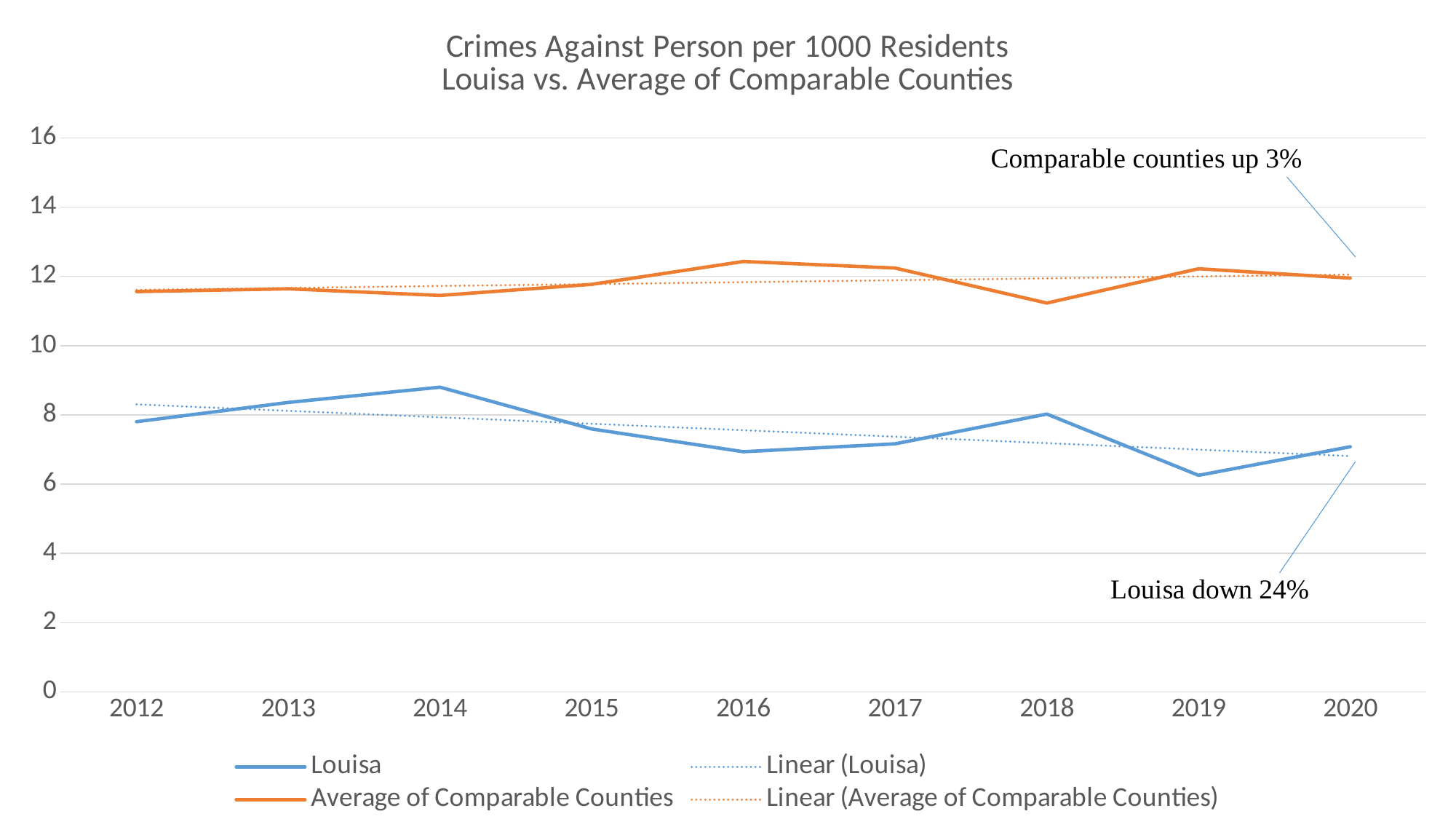
In which year is the Average of Comparable Counties line at its highest? 2016 How many years are plotted along the x axis? 9 In which year is the Louisa line at its lowest? 2019 Is the value for Louisa in 2019 greater or less than 8? less What kind of chart is shown on the slide? line chart In which year is the Louisa line at its highest? 2014 According to the annotation on the chart, by what percentage did Louisa's rate go down? 24% In 2020, which series is higher: Louisa or Average of Comparable Counties? Average of Comparable Counties Does the Louisa line generally rise or fall from 2012 to 2020? fall How many entries does the legend list? 4 Is the value for Average of Comparable Counties in 2016 greater or less than 12? greater In which year is the Average of Comparable Counties line at its lowest? 2018